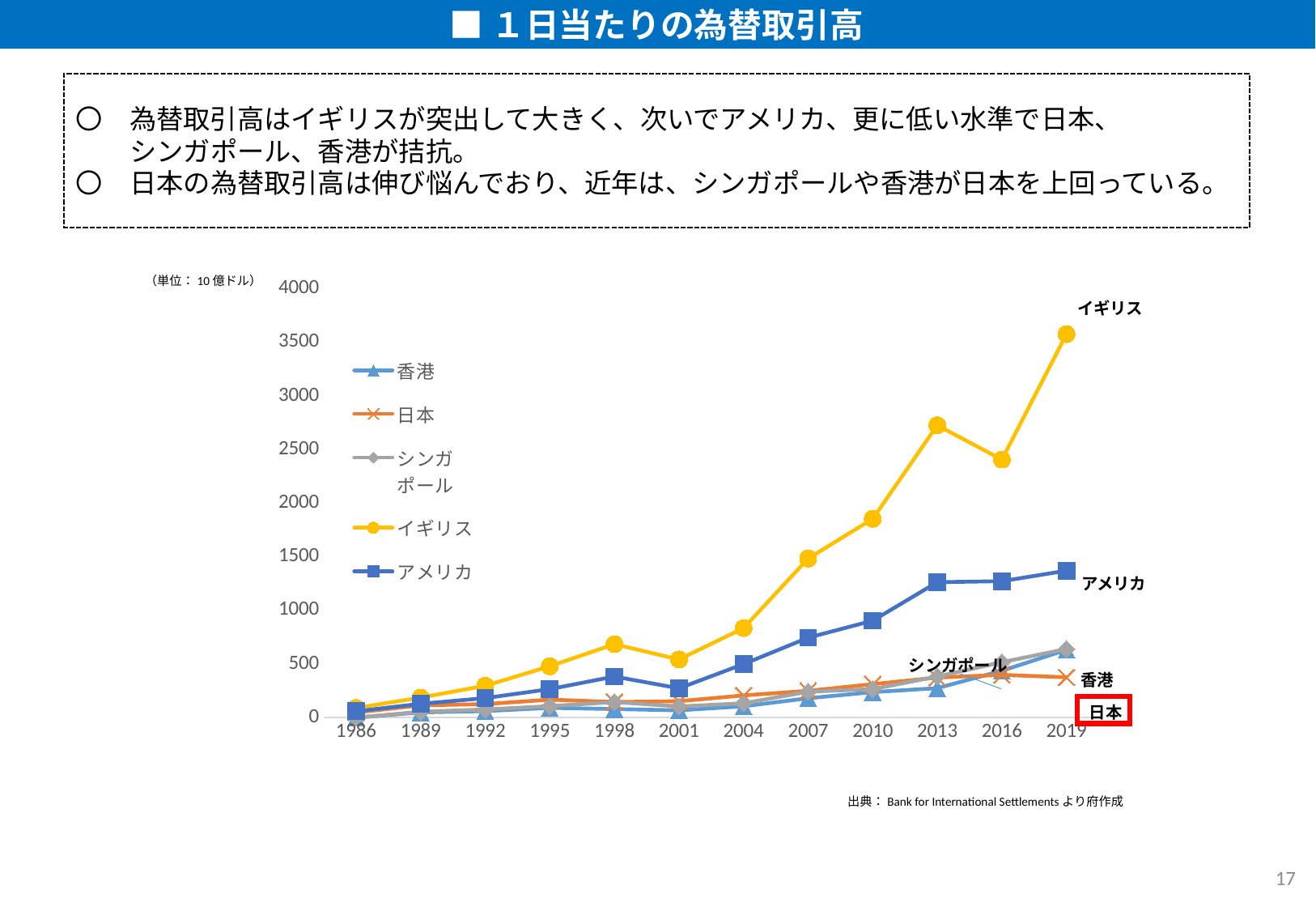
Which series has the highest value in 2019? イギリス Which series has the lowest value in 2019? 日本 Is the value for アメリカ in 2019 greater or less than 1000? greater Is the value for イギリス in 2016 greater or less than 2500? less In 2019, which is larger, the value for 香港 or the value for 日本? 香港 Is the value for イギリス in 2019 greater or less than 3000? greater Does the value for イギリス generally rise or fall from 1986 to 2019? rise How many series does the legend list? 5 How many years are shown on the x axis? 12 What kind of chart is shown on the slide? line chart What unit is stated for the values in the chart? 10億ドル